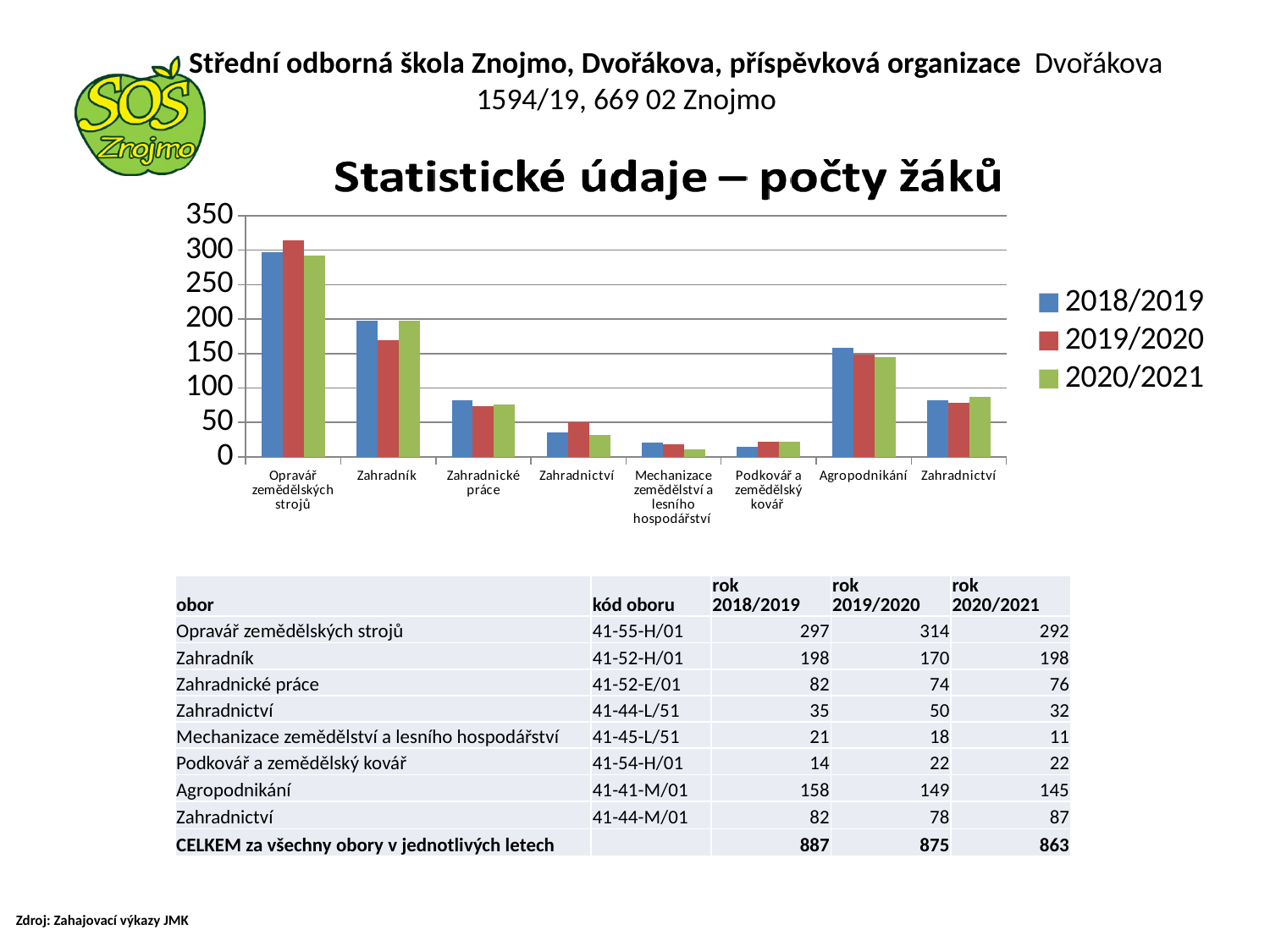
What is the value for Opravář zemědělských strojů in 2019/2020, as printed in the table on the slide? 314 How many series does the chart legend list? 3 What is the title of the chart? Statistické údaje – počty žáků What is the value for Agropodnikání in 2018/2019, as printed in the table on the slide? 158 Is the value for Agropodnikání in 2020/2021 greater or less than 150? less How many categories are shown on the x axis of the chart? 8 Using the values printed in the table, what is the difference between the 2018/2019 and 2019/2020 values for Zahradník? 28 Which category has the highest value in the 2019/2020 series? Opravář zemědělských strojů Which is larger for Zahradník: the 2018/2019 value or the 2019/2020 value? 2018/2019 What kind of chart is shown on the slide? bar chart Is the value for Zahradník in 2018/2019 greater or less than 150? greater Which category has the lowest value in the 2020/2021 series? Mechanizace zemědělství a lesního hospodářství